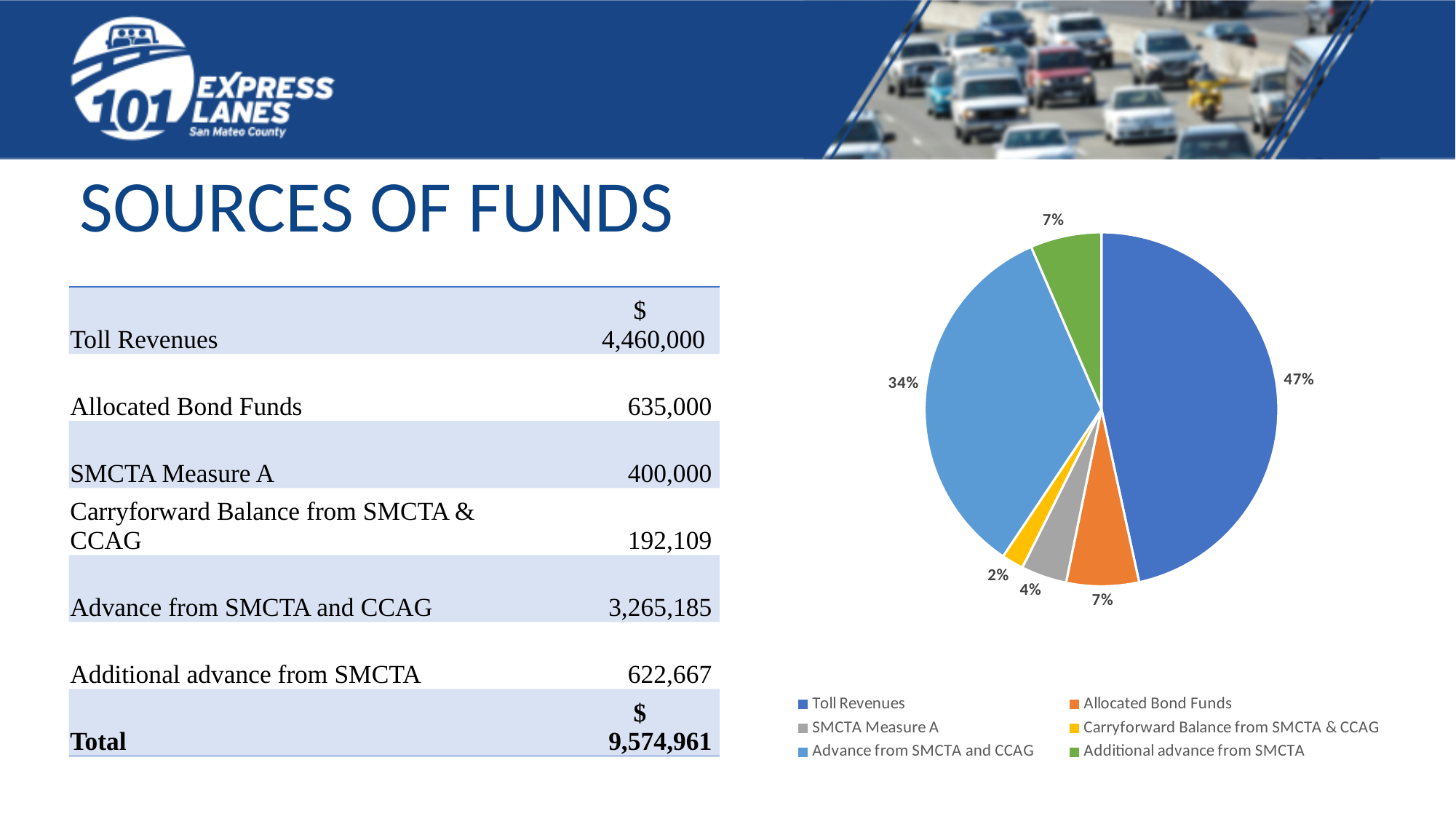
What share of the pie does SMCTA Measure A represent? 4% Which category has the largest slice of the pie? Toll Revenues What colour is the slice for Additional advance from SMCTA? green What kind of chart is shown on the slide? pie chart What share of the pie does Advance from SMCTA and CCAG represent? 34% What share of the pie does Carryforward Balance from SMCTA & CCAG represent? 2% Which is larger, the share for Advance from SMCTA and CCAG or the share for Allocated Bond Funds? Advance from SMCTA and CCAG What is the difference in percentage points between the Toll Revenues share and the Advance from SMCTA and CCAG share? 13 percentage points How many categories does the pie chart show? 6 Which category has the smallest slice of the pie? Carryforward Balance from SMCTA & CCAG